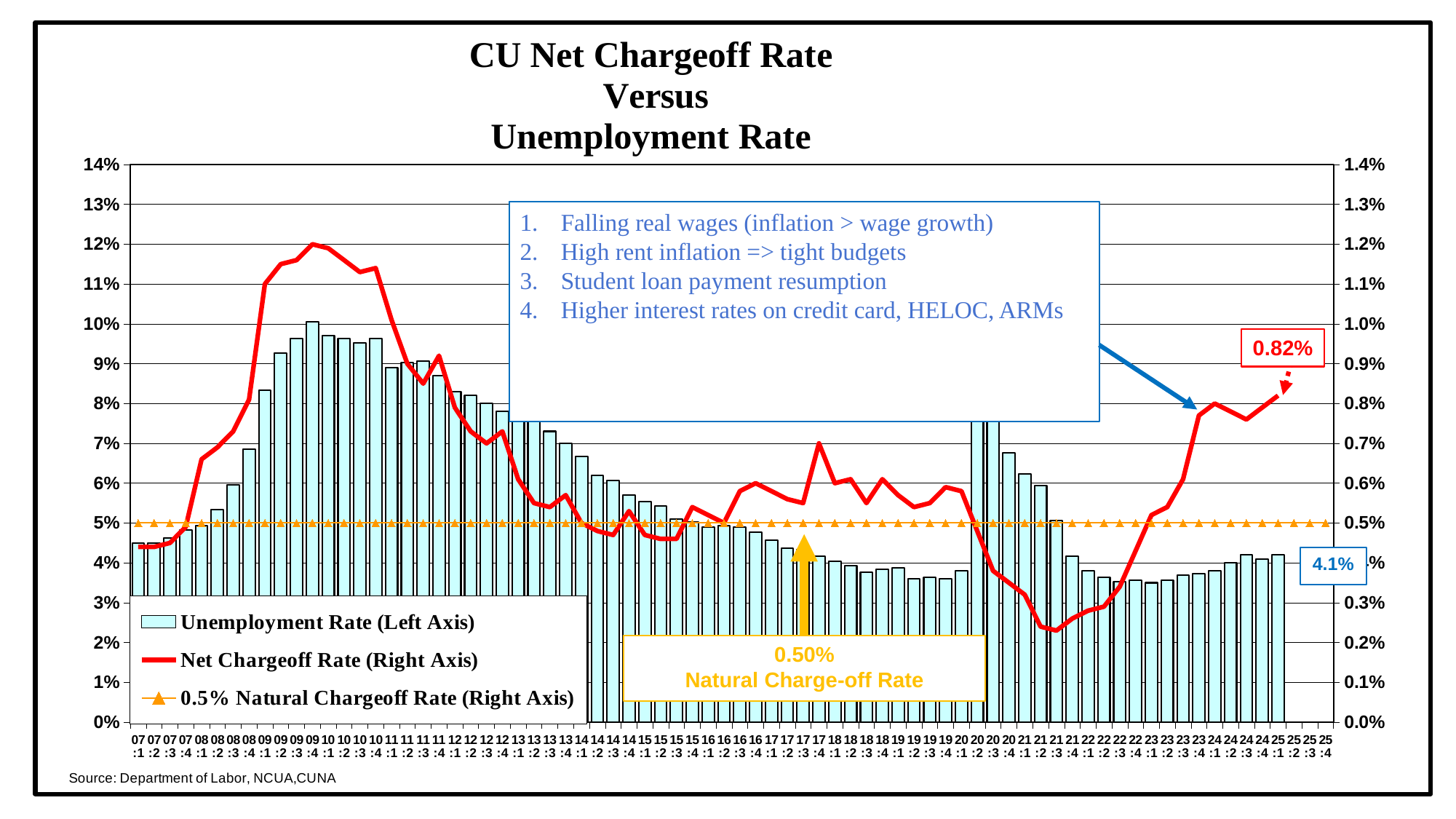
What is the most recent Unemployment Rate value labeled on the chart? 4.1% How many series does the legend list? 3 What is the most recent Net Chargeoff Rate value labeled on the chart? 0.82% Which is larger, the Net Chargeoff Rate in 09:4 or in 25:1? 09:4 Does the Net Chargeoff Rate rise or fall from 21:3 to 25:1? rise By how much does the latest Net Chargeoff Rate (0.82%) exceed the 0.50% Natural Charge-off Rate? 0.32% What is the Natural Charge-off Rate shown on the chart? 0.50% What is the title of the chart? CU Net Chargeoff Rate Versus Unemployment Rate Is the Unemployment Rate in 09:4 greater or less than 9%? greater Is the Net Chargeoff Rate in 21:3 greater or less than 0.3%? less What kind of chart is shown on the slide? A combined bar and line chart On which axis is the Unemployment Rate plotted? Left axis